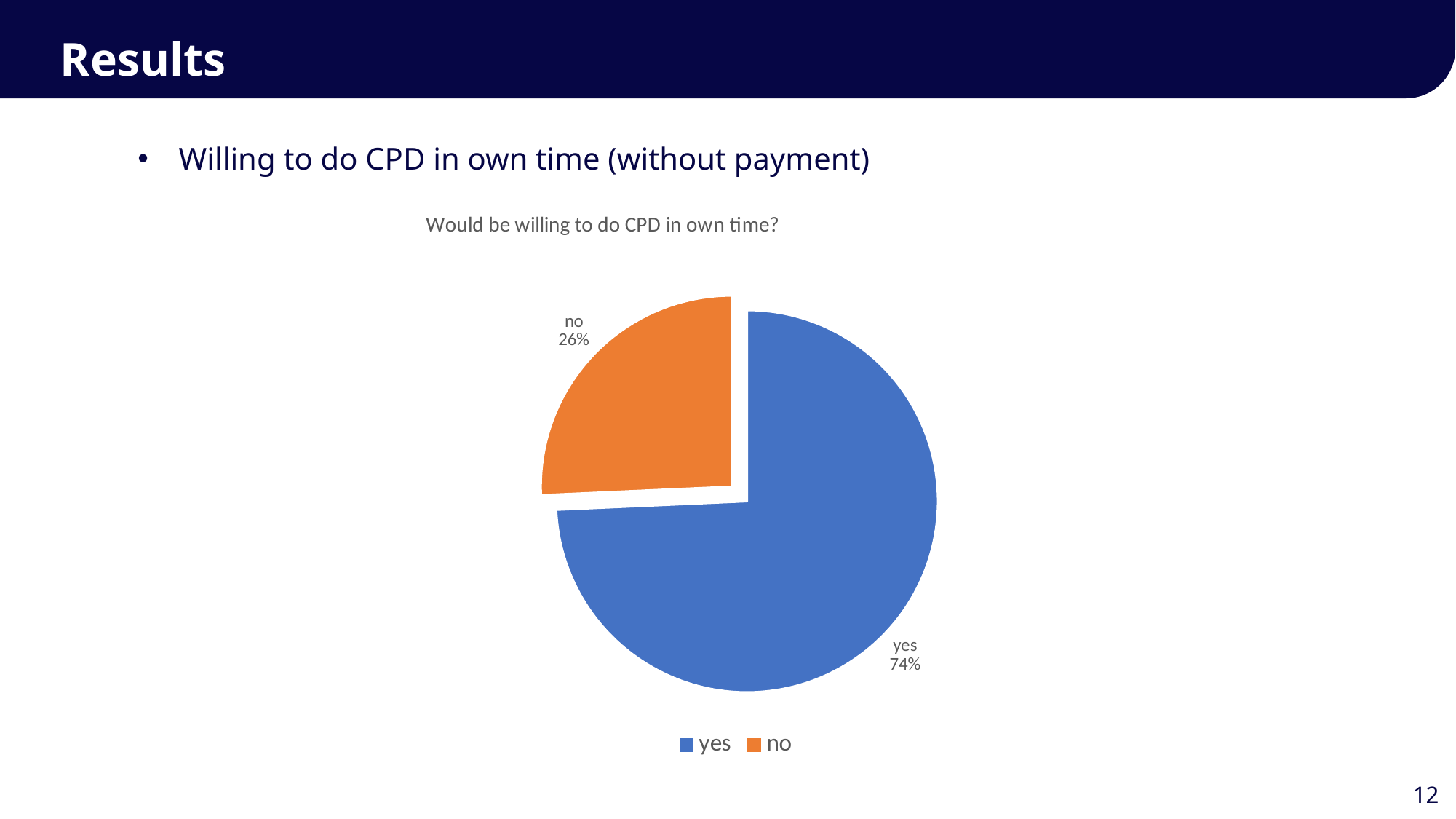
What is the title of the chart? Would be willing to do CPD in own time? What share of the pie is labelled "no"? 26% How many entries does the legend list? 2 What kind of chart is shown on the slide? pie chart Which slice of the pie is the largest? yes Which is larger, the "yes" slice or the "no" slice? yes Which slice of the pie is the smallest? no How many slices does the pie chart have? 2 What share of the pie is labelled "yes"? 74% What colour is the "no" slice? orange What is the difference in percentage points between the "yes" and "no" slices? 48